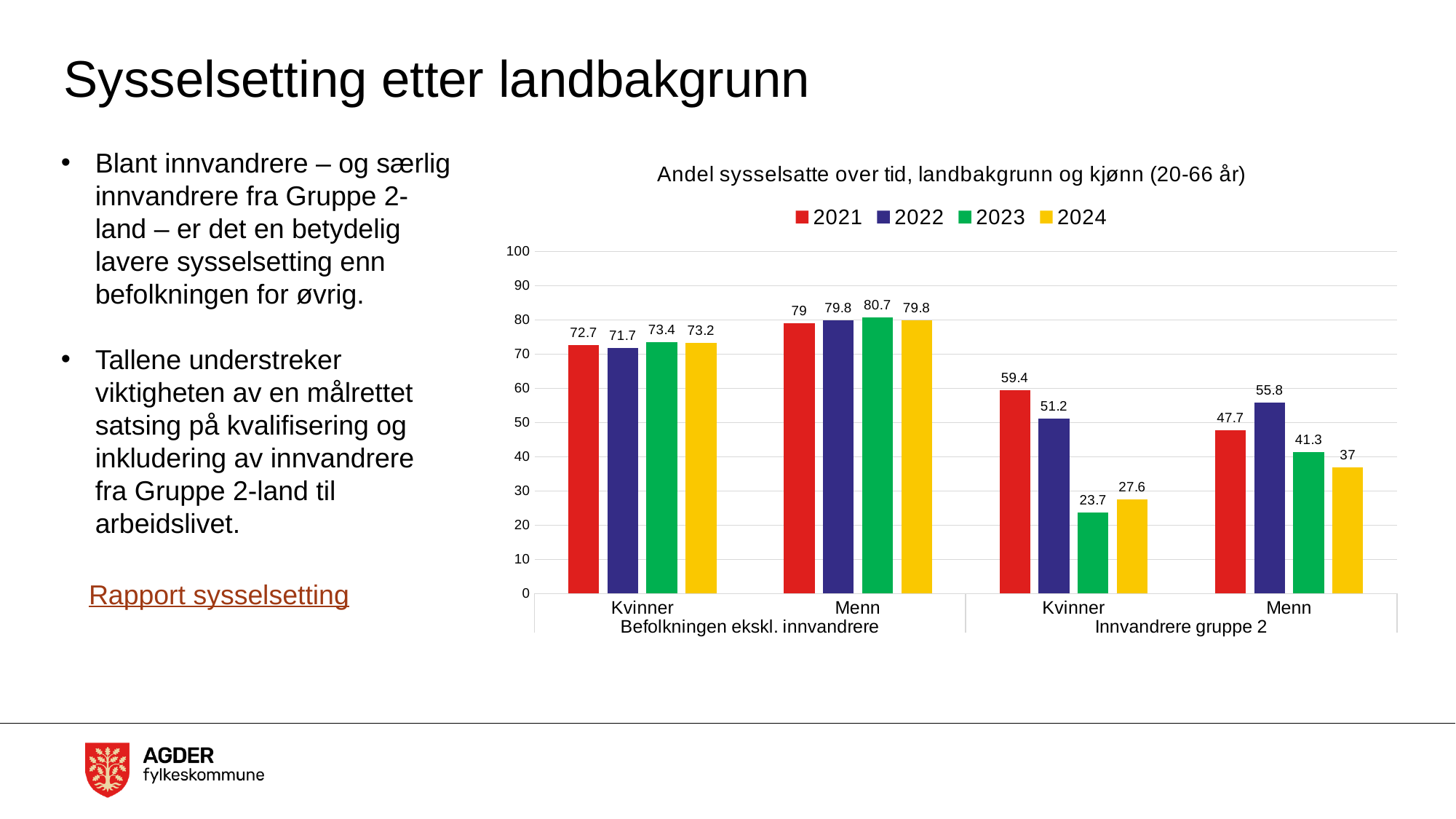
Which is larger for 2022: Kvinner in Innvandrere gruppe 2 or Menn in Innvandrere gruppe 2? Menn in Innvandrere gruppe 2 What is the 2024 value for Menn in the Innvandrere gruppe 2 group? 37 Which year has the lowest value for Kvinner in the Innvandrere gruppe 2 group? 2023 What is the 2021 value for Menn in the Befolkningen ekskl. innvandrere group? 79 How many series does the legend list? 4 What is the difference between the 2021 and 2024 values for Kvinner in the Innvandrere gruppe 2 group? 31.8 Is the 2022 value for Menn in the Innvandrere gruppe 2 group greater or less than 50? greater What is the 2023 value for Kvinner in the Innvandrere gruppe 2 group? 23.7 Which year has the highest value for Menn in the Befolkningen ekskl. innvandrere group? 2023 Do the values for Menn in the Innvandrere gruppe 2 group rise or fall from 2022 to 2024? fall What kind of chart is shown on the slide? bar chart What is the title of the chart? Andel sysselsatte over tid, landbakgrunn og kjønn (20-66 år)